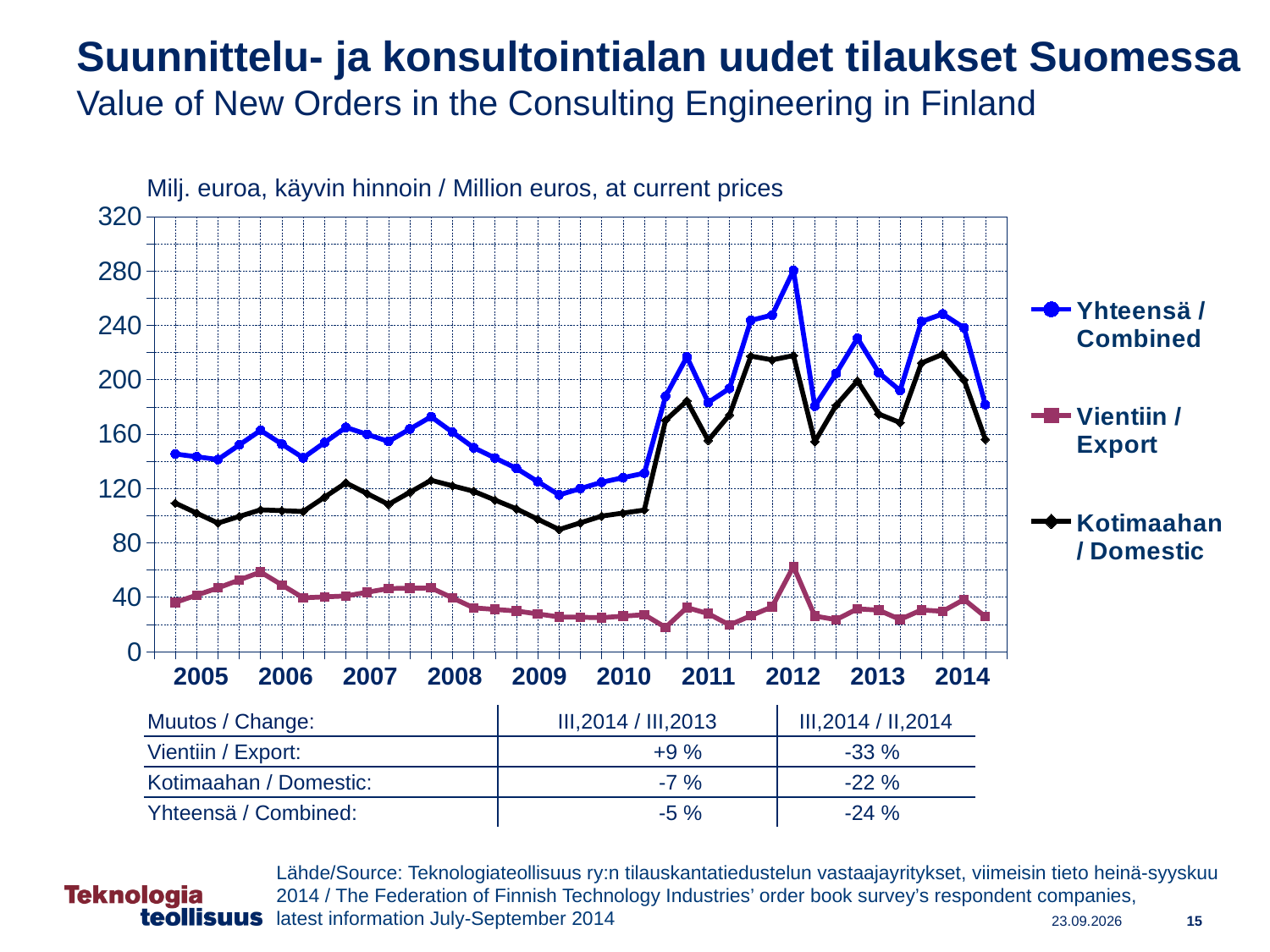
How many years are labelled on the x axis? 10 Is the lowest value of the Kotimaahan / Domestic series in 2009 greater or less than 120? less Is the peak value of the Yhteensä / Combined series in 2012 greater or less than 240? greater Which series is plotted with the blue line? Yhteensä / Combined How many series does the legend list? 3 What kind of chart is shown on the slide? line chart In 2012, which is larger: the Kotimaahan / Domestic value or the Vientiin / Export value? Kotimaahan / Domestic Is the last plotted value of the Yhteensä / Combined series in 2014 greater or less than 160? greater Which series has the highest values throughout the chart? Yhteensä / Combined What unit is stated above the chart? Milj. euroa, käyvin hinnoin / Million euros, at current prices Which series has the lowest values throughout the chart? Vientiin / Export